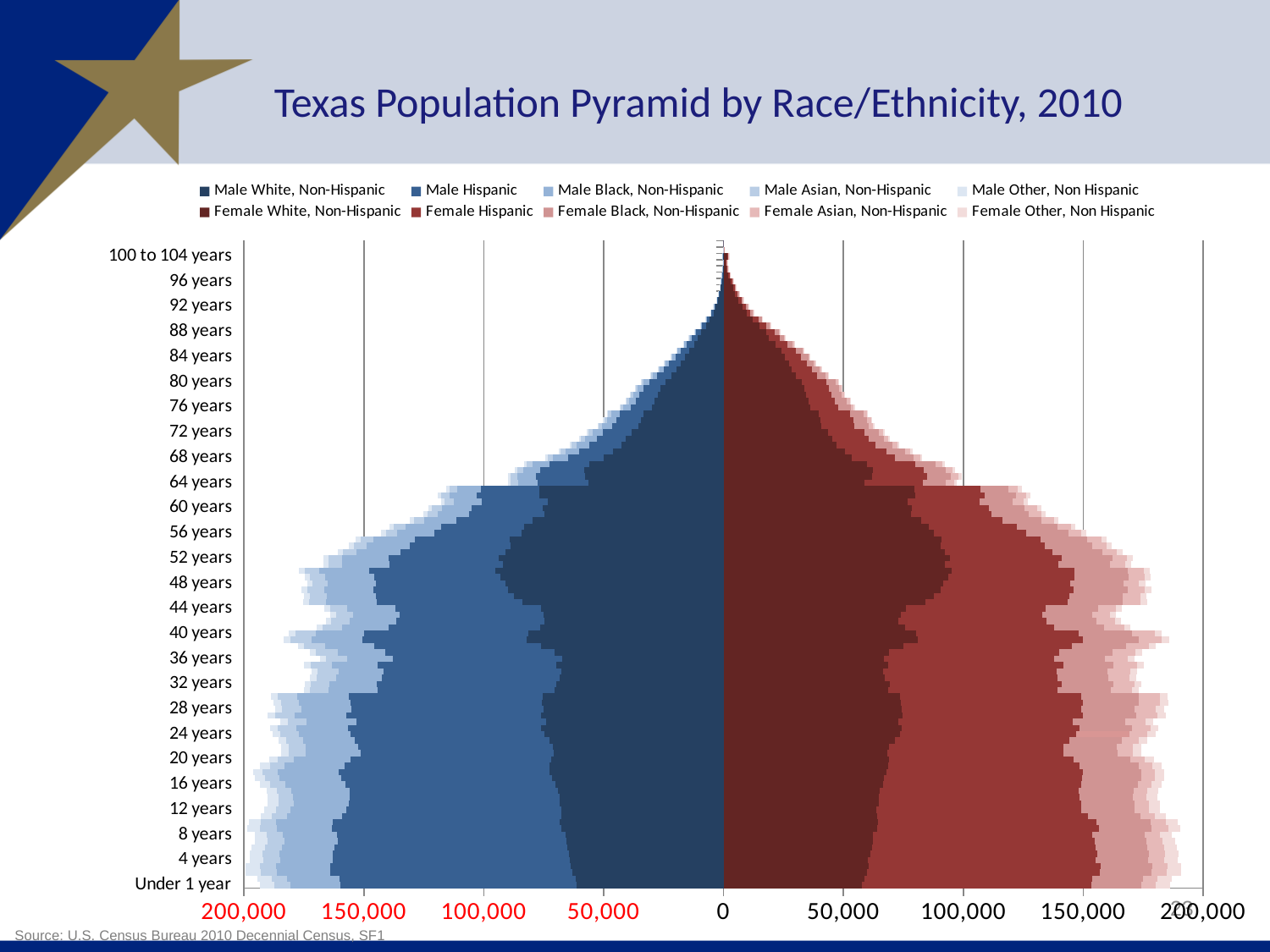
What kind of chart is shown on the slide? Stacked bar chart (population pyramid) Is the total male population for Under 1 year greater or less than 150,000? greater Moving from 64 years up to 100 to 104 years, do the bar lengths rise or fall? fall How many series does the legend list? 10 Is the total male population for 80 years greater or less than 50,000? less Is the total female population for Under 1 year greater or less than 150,000? greater Which legend entry is shown in the darkest blue colour? Male White, Non-Hispanic What is the title of the chart? Texas Population Pyramid by Race/Ethnicity, 2010 Which is larger, the total male population at Under 1 year or at 80 years? Under 1 year